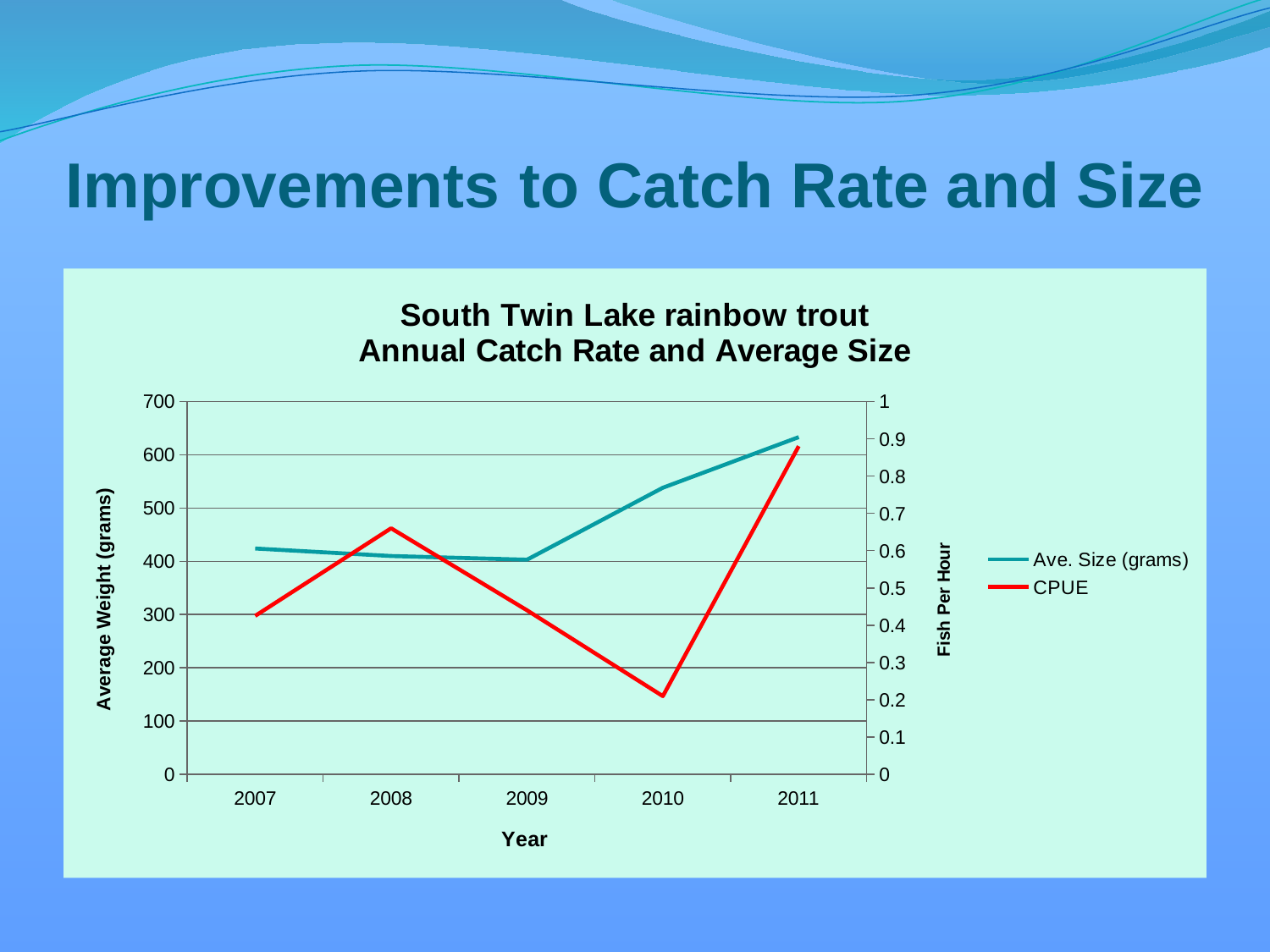
How many years are plotted along the x axis? 5 In which year is the Ave. Size (grams) value highest? 2011 Is the Ave. Size (grams) value for 2009 greater or less than 500? less What is the label of the right-hand vertical axis? Fish Per Hour In which year is the CPUE value highest? 2011 Which year has the larger CPUE value, 2008 or 2009? 2008 In which year is the CPUE value lowest? 2010 Is the Ave. Size (grams) value for 2011 greater or less than 600? greater Does the Ave. Size (grams) line rise or fall from 2009 to 2011? rise Is the CPUE value for 2010 greater or less than 0.3? less What kind of chart is shown on the slide? line chart How many series does the legend list? 2